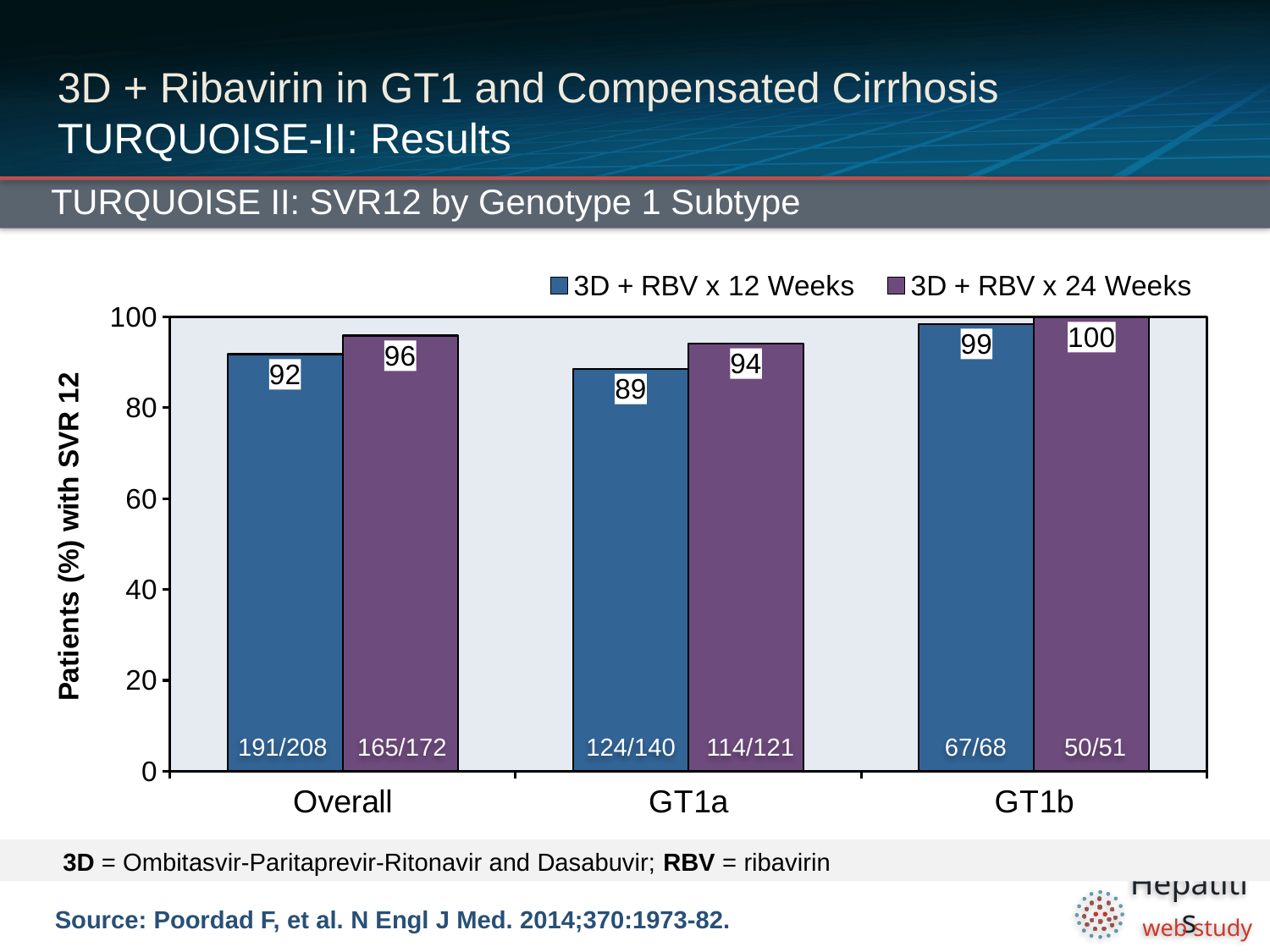
What is the SVR12 rate for 3D + RBV x 12 Weeks in the GT1b group? 99 What is the SVR12 rate for 3D + RBV x 12 Weeks in the Overall group? 92 What is the SVR12 rate for 3D + RBV x 24 Weeks in the GT1a group? 94 How many genotype categories are shown on the x axis? 3 What fraction of patients is shown inside the 3D + RBV x 12 Weeks bar for GT1a? 124/140 What kind of chart is shown on the slide? Bar chart Which genotype subtype has the highest SVR12 rate for 3D + RBV x 24 Weeks? GT1b In the Overall group, which regimen has the higher SVR12 rate, 3D + RBV x 12 Weeks or 3D + RBV x 24 Weeks? 3D + RBV x 24 Weeks What is the label of the y axis? Patients (%) with SVR 12 What is the difference in SVR12 rate between 3D + RBV x 24 Weeks and 3D + RBV x 12 Weeks in the GT1a group? 5 How many series does the legend list? 2 Which category has the lowest SVR12 rate for 3D + RBV x 12 Weeks? GT1a